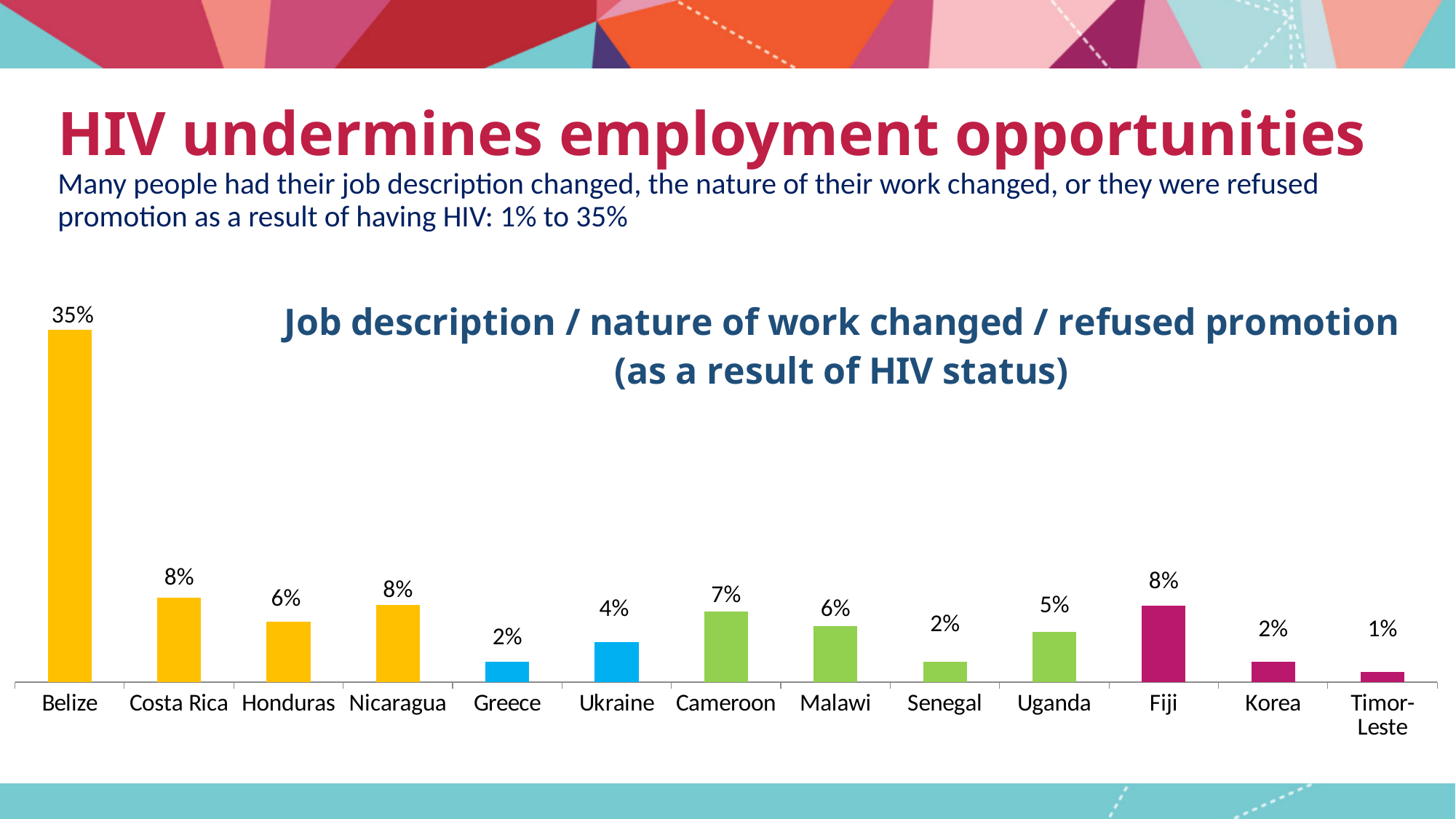
Which country has the highest value? Belize What kind of chart is shown on the slide? Bar chart What is the difference between the values for Belize and Costa Rica? 27% Which is larger, the value for Fiji or the value for Korea? Fiji Which is larger, the value for Ukraine or the value for Cameroon? Cameroon What is the value for Cameroon? 7% What is the title of the chart? Job description / nature of work changed / refused promotion (as a result of HIV status) What is the value for Uganda? 5% What is the difference between the values for Malawi and Senegal? 4% Which country has the lowest value? Timor-Leste How many countries are shown on the chart? 13 What is the value for Belize? 35%